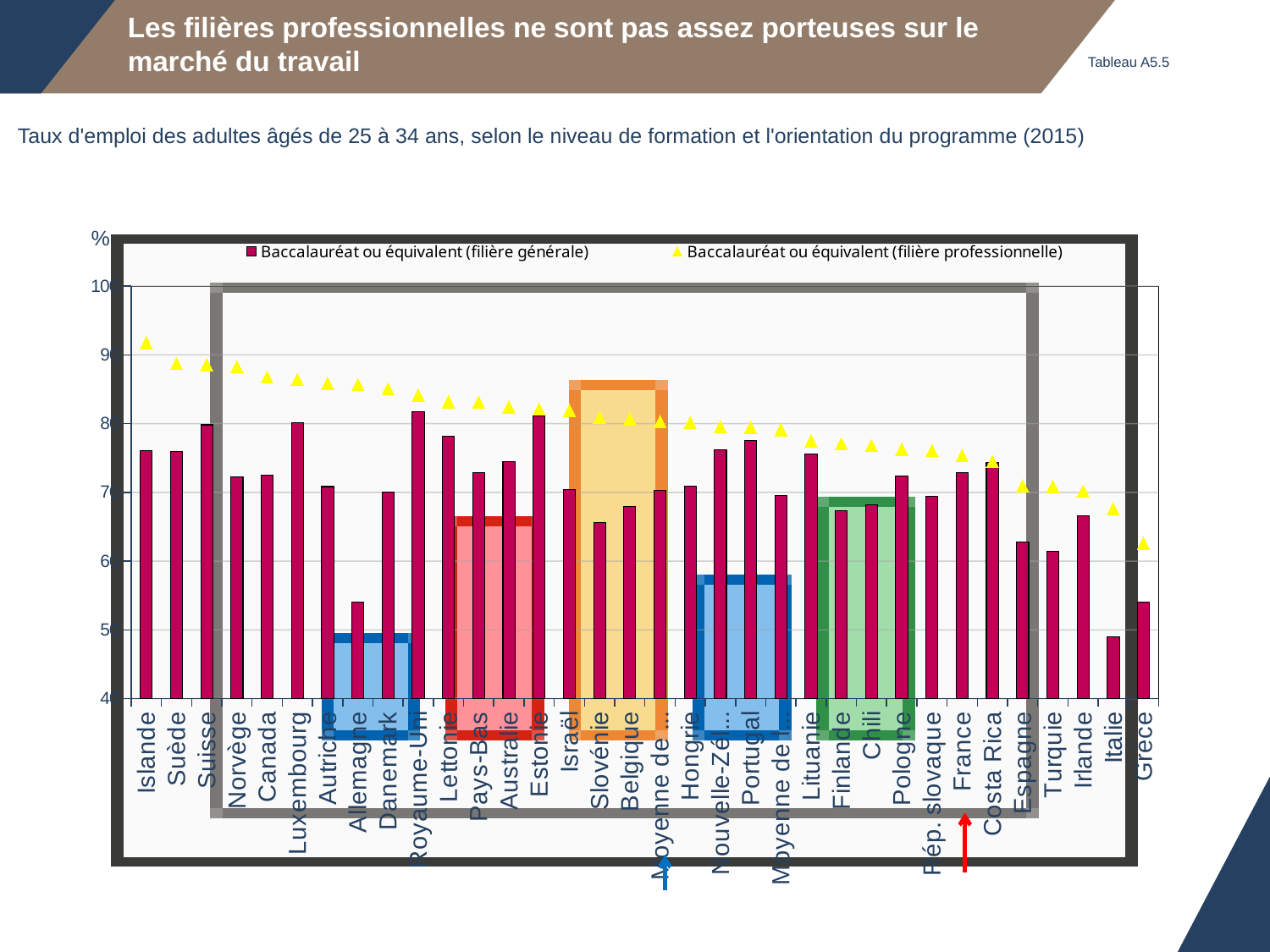
Is the triangle value for Islande (filière professionnelle) greater or less than 90? greater Is the bar value for Royaume-Uni (filière générale) greater or less than 80? greater Which category has the lowest bar for 'Baccalauréat ou équivalent (filière générale)'? Italie Which has the larger bar for 'Baccalauréat ou équivalent (filière générale)', Turquie or Irlande? Irlande Which category has the lowest triangle marker for 'Baccalauréat ou équivalent (filière professionnelle)'? Grèce Which category has the highest triangle marker for 'Baccalauréat ou équivalent (filière professionnelle)'? Islande How many series does the chart legend list? 2 Do the triangle values for 'Baccalauréat ou équivalent (filière professionnelle)' rise or fall from left to right along the x axis? fall Is the bar value for Allemagne (filière générale) greater or less than 60? less How many countries or categories are shown along the x axis of the chart? 34 What kind of chart is shown on the slide? combination chart (bars with triangle markers)